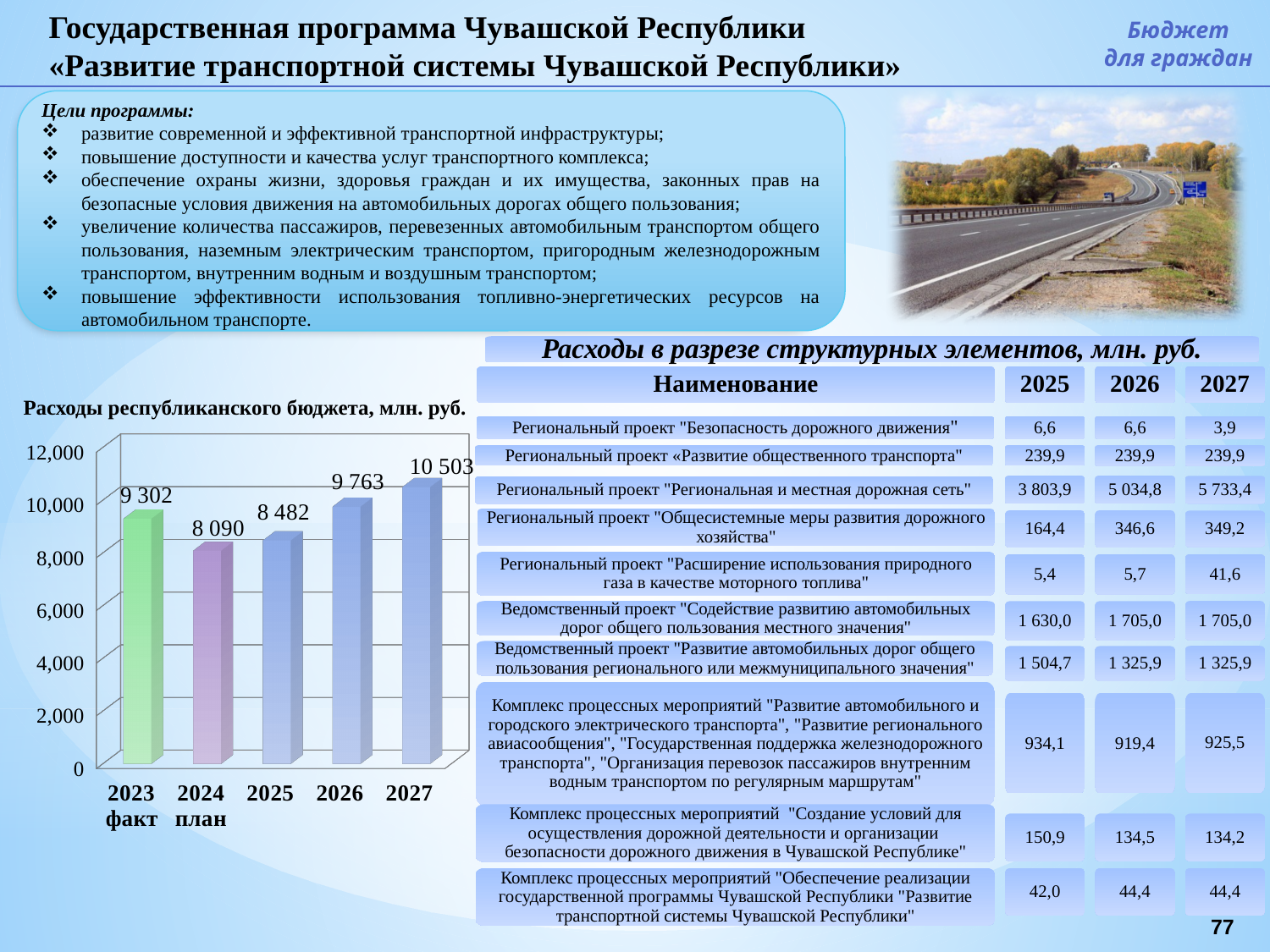
What type of chart is 'Расходы республиканского бюджета, млн. руб.'? bar chart Do the values in the chart 'Расходы республиканского бюджета, млн. руб.' rise or fall from 2024 to 2027? rise What is the value for 2024 in the chart 'Расходы республиканского бюджета, млн. руб.'? 8 090 Which year has the lowest value in the chart 'Расходы республиканского бюджета, млн. руб.'? 2024 What is the difference between the values for 2023 and 2024 in the chart 'Расходы республиканского бюджета, млн. руб.'? 1 212 Is the value for 2026 in the chart 'Расходы республиканского бюджета, млн. руб.' greater or less than 10,000? less Which year has the highest value in the chart 'Расходы республиканского бюджета, млн. руб.'? 2027 How many bars are shown in the chart 'Расходы республиканского бюджета, млн. руб.'? 5 What is the difference between the values for 2027 and 2026 in the chart 'Расходы республиканского бюджета, млн. руб.'? 740 What is the value for 2023 in the chart 'Расходы республиканского бюджета, млн. руб.'? 9 302 In the chart 'Расходы республиканского бюджета, млн. руб.', which is larger, the value for 2025 or the value for 2023? 2023 What is the value for 2027 in the chart 'Расходы республиканского бюджета, млн. руб.'? 10 503